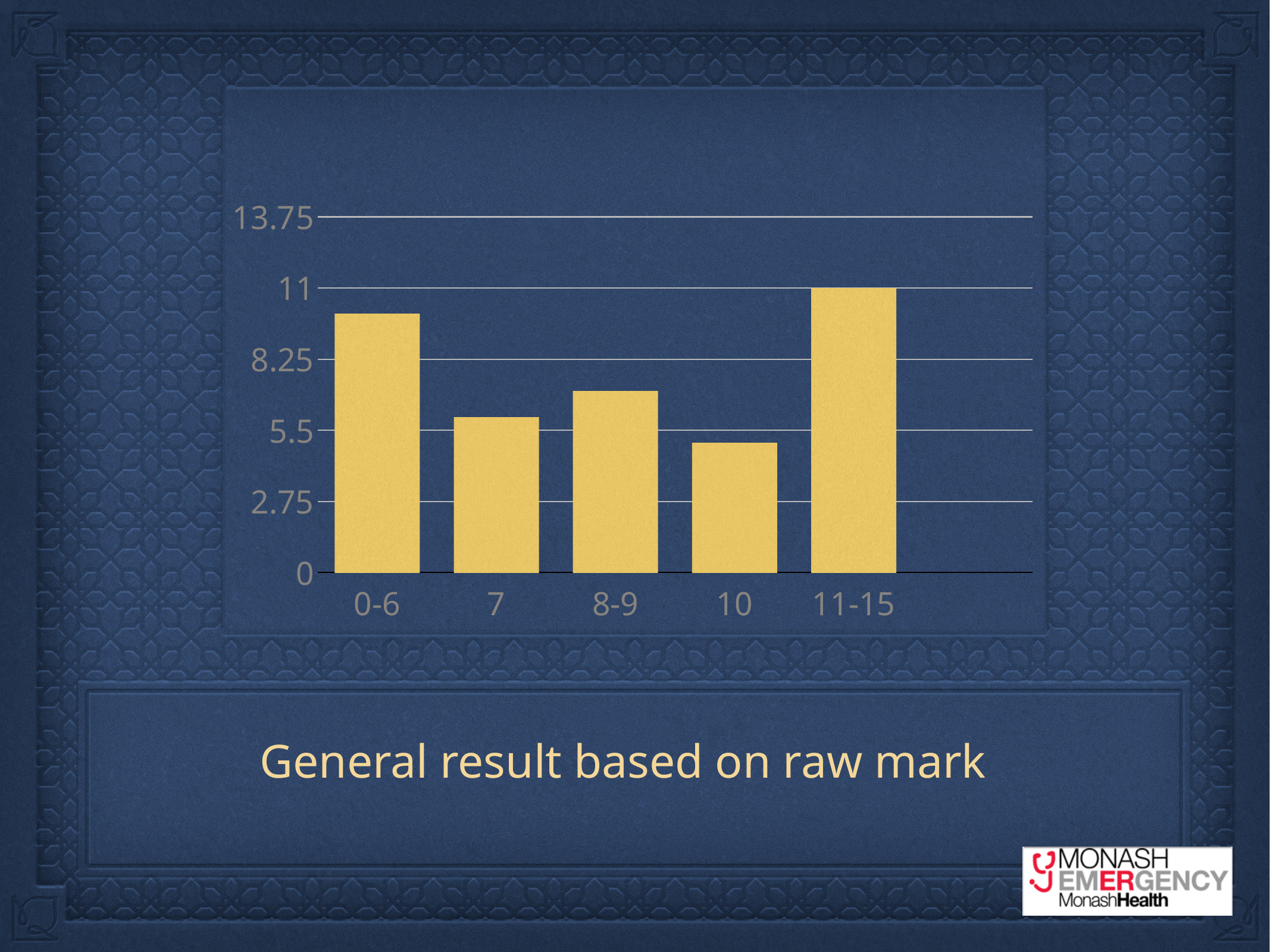
What is the title text shown below the chart? General result based on raw mark Is the value for 7 greater or less than 5.5? greater Is the value for 8-9 greater or less than 8.25? less Which category has the highest bar in the chart? 11-15 Which is larger, the value for 0-6 or the value for 7? 0-6 What colour are the bars in the chart? yellow What kind of chart is shown on the slide? bar chart Is the value for 0-6 greater or less than 8.25? greater How many categories are shown on the x axis of the chart? 5 Which category has the lowest bar in the chart? 10 What is the value for the 11-15 category? 11